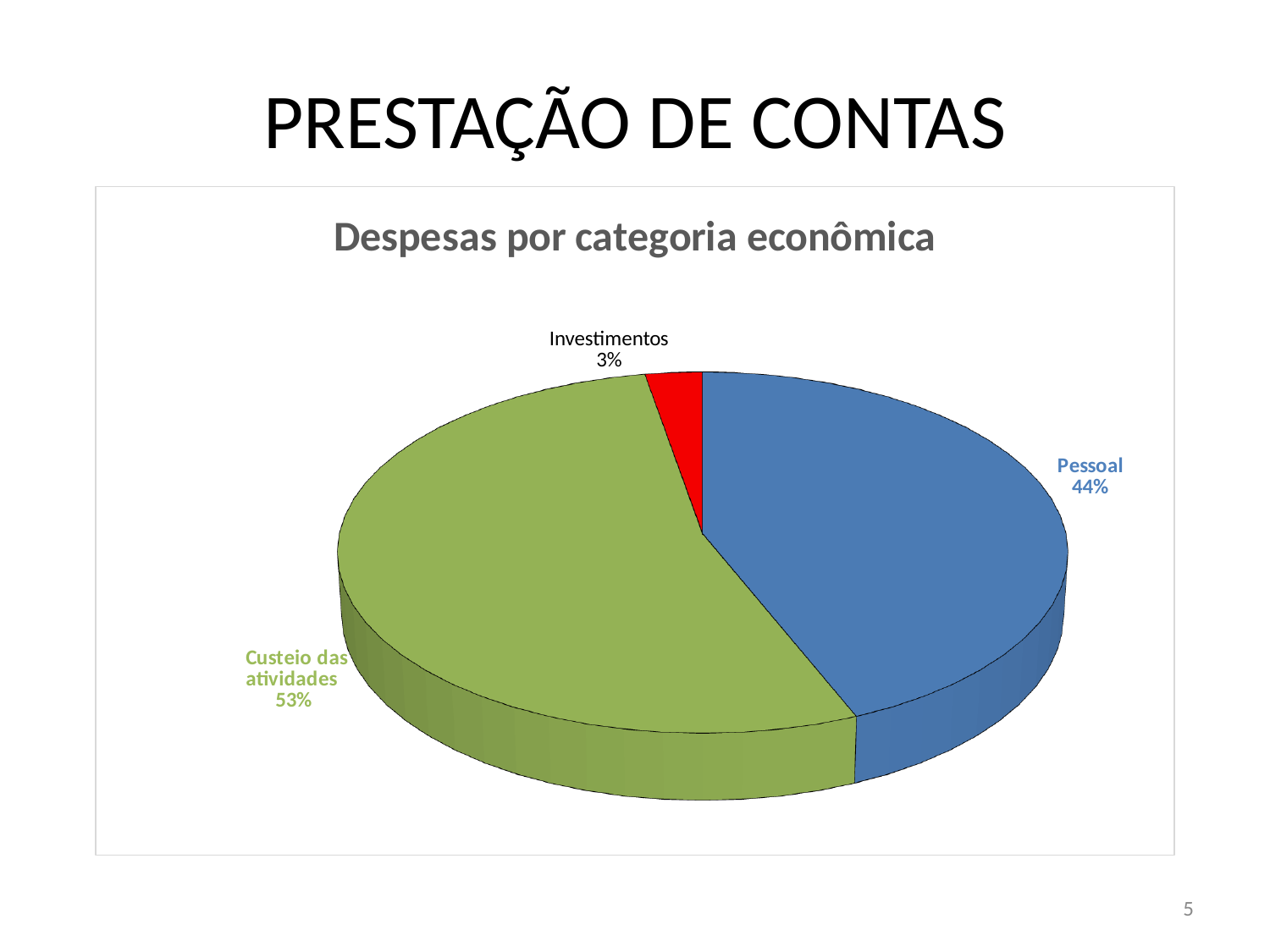
Which category has the largest slice of the pie? Custeio das atividades What is the title of the chart? Despesas por categoria econômica What is the difference in percentage points between Custeio das atividades and Pessoal? 9 percentage points What colour is the Investimentos slice? Red What share of the pie does Pessoal represent? 44% What is the difference in percentage points between Pessoal and Investimentos? 41 percentage points What share of the pie does Investimentos represent? 3% Which category has the smallest slice of the pie? Investimentos How many categories are shown in the pie chart? 3 Which is larger, the share for Pessoal or the share for Custeio das atividades? Custeio das atividades What share of the pie does Custeio das atividades represent? 53% What kind of chart is shown on the slide? Pie chart